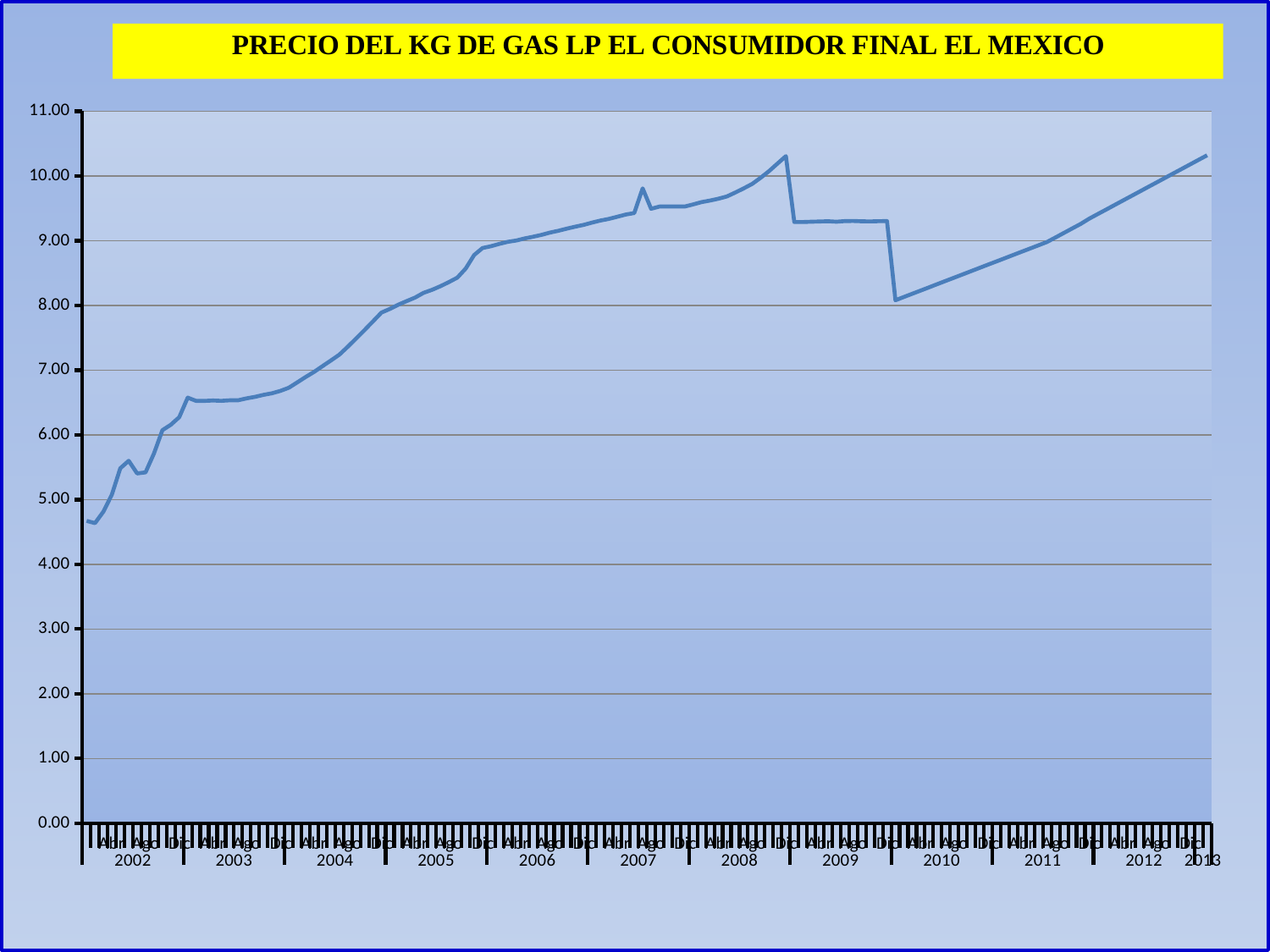
What is the title of the chart? PRECIO DEL KG DE GAS LP EL CONSUMIDOR FINAL EL MEXICO Which is larger, the value at the end of 2008 or the value at the start of 2010? the value at the end of 2008 Is the value during 2009 greater or less than 9.00? greater Is the value at the start of 2002 greater or less than 5.00? less What is the highest value shown on the vertical axis of the chart? 11.00 Is the value at the end of the series in 2013 greater or less than 10.00? greater Overall, does the price rise or fall from 2002 to 2013? rise How many year labels appear along the x axis? 12 What kind of chart is shown on the slide? line chart